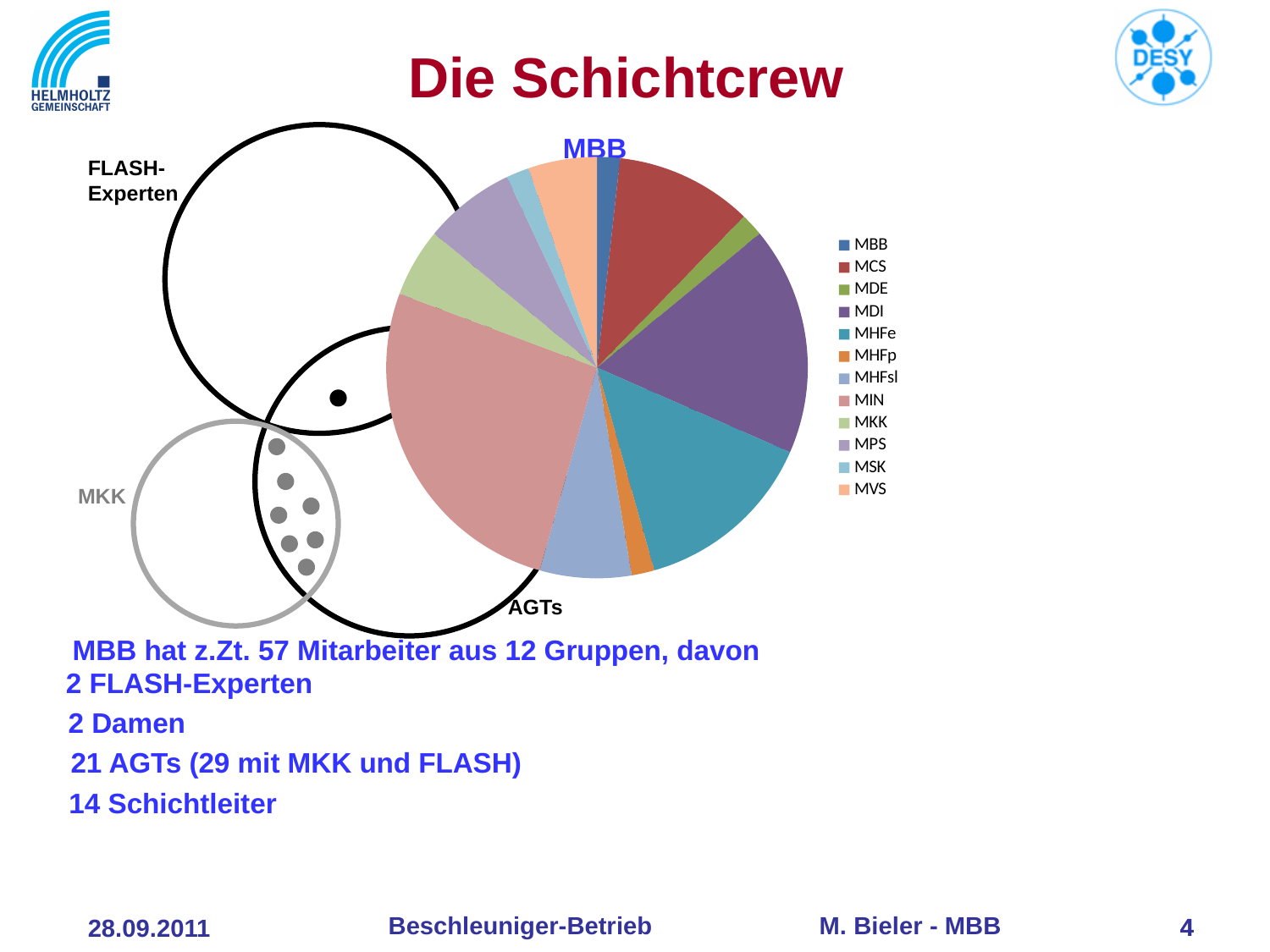
Which slice is larger in the pie chart, MPS or MSK? MPS What is the first entry listed in the pie chart's legend? MBB Which category has the largest slice in the pie chart? MIN What kind of chart is shown on the slide? pie chart Which slice is larger in the pie chart, MDI or MCS? MDI What is the last entry listed in the pie chart's legend? MVS Which slice is larger in the pie chart, MHFsl or MHFp? MHFsl How many categories does the pie chart's legend list? 12